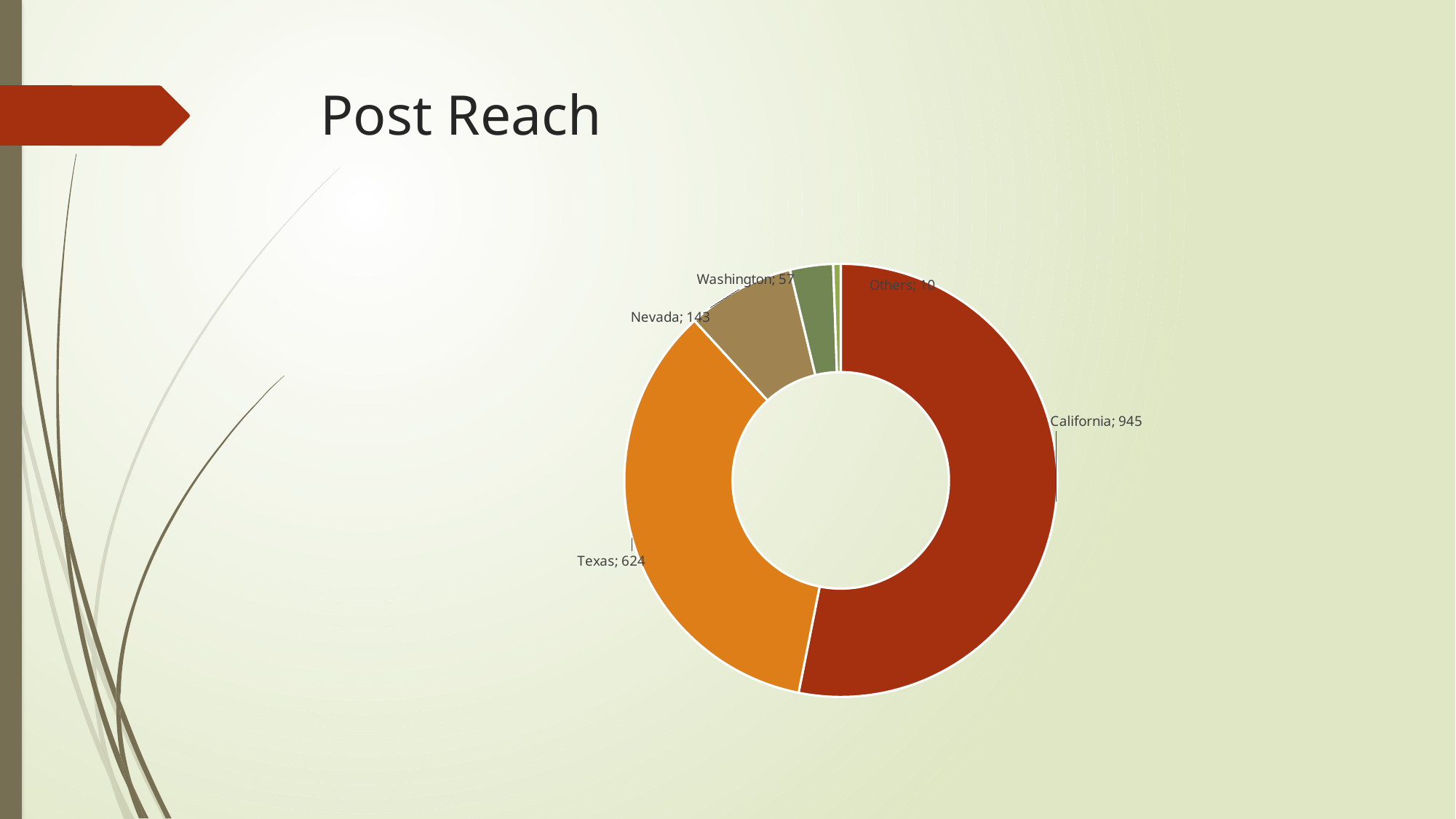
What is the value for Others in the Post Reach chart? 10 What is the value for Texas in the Post Reach chart? 624 Which category has the lowest value in the Post Reach chart? Others What kind of chart is shown on the slide? doughnut chart What is the value for Washington in the Post Reach chart? 57 What is the value for Nevada in the Post Reach chart? 143 What is the value for California in the Post Reach chart? 945 How many categories are shown in the Post Reach chart? 5 What is the title of the slide containing the chart? Post Reach Which category has the highest value in the Post Reach chart? California What is the difference between the values for California and Texas? 321 Which is larger, the value for Nevada or the value for Washington? Nevada